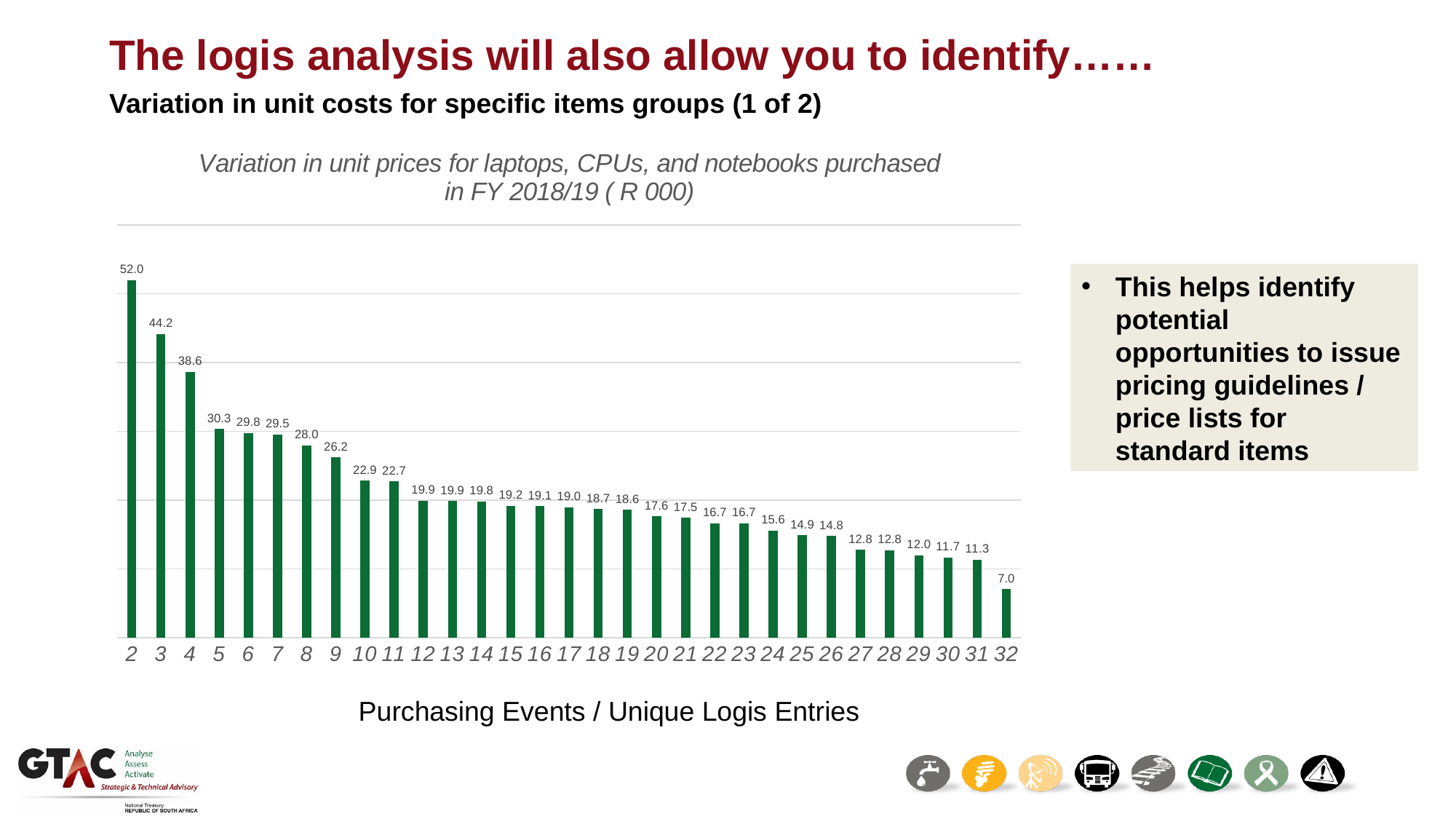
Do the unit price values rise or fall from left to right along the x axis? fall What is the unit price value for purchasing event 9? 26.2 What is the unit price value for purchasing event 2? 52.0 What is the unit price value for purchasing event 24? 15.6 What is the difference between the unit price for purchasing event 31 and purchasing event 32? 4.3 Which purchasing event has the lowest unit price? 32 Which has a higher unit price, purchasing event 5 or purchasing event 10? 5 How many bars are plotted in the chart? 31 Which purchasing event has the highest unit price? 2 What is the difference between the unit price for purchasing event 2 and purchasing event 3? 7.8 What is the x-axis label of the chart? Purchasing Events / Unique Logis Entries What type of chart is shown on the slide? bar chart